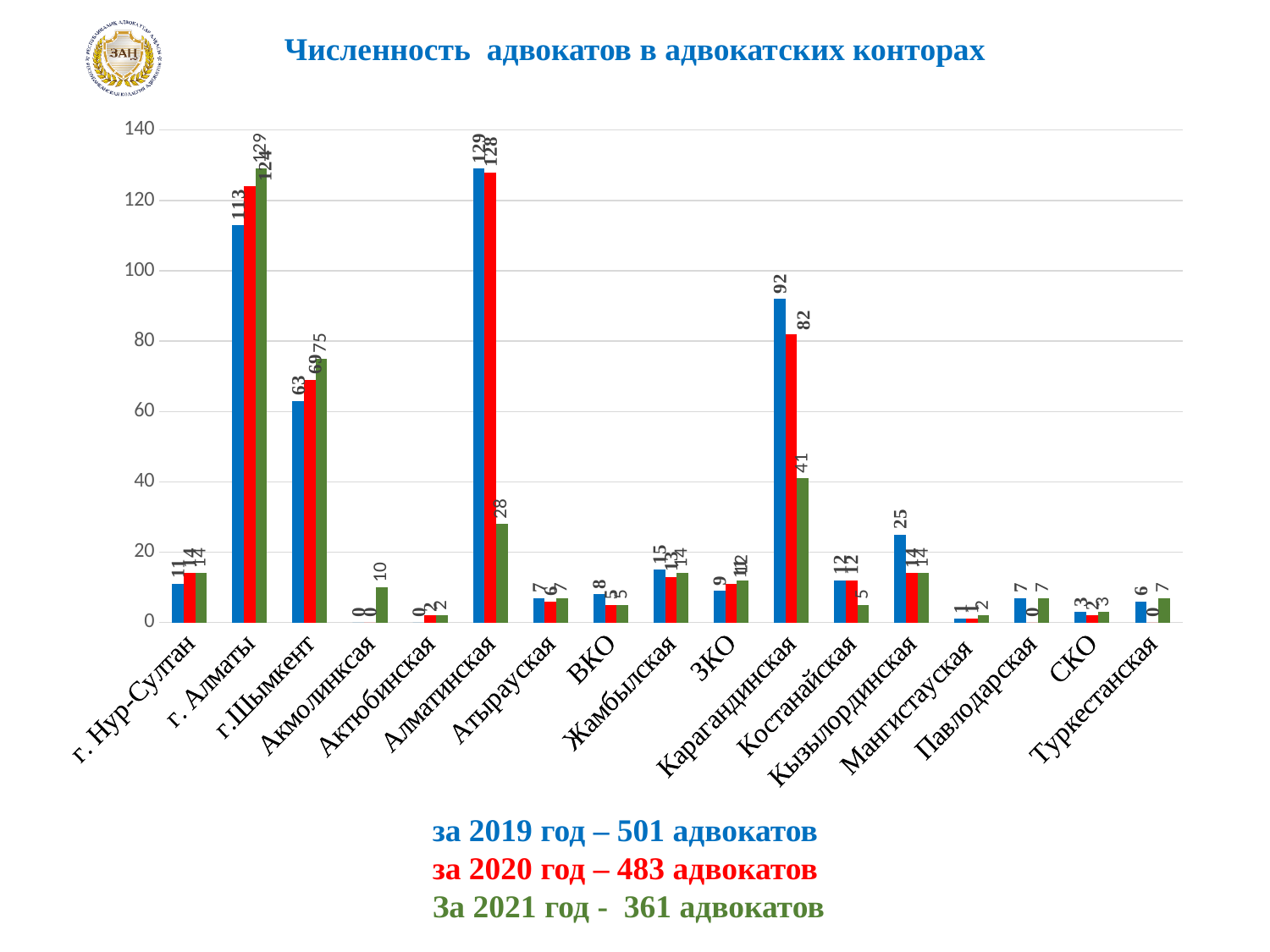
What kind of chart is shown on the slide? bar chart How many regions (categories) are shown along the x axis of the chart? 17 What is the value of the blue (2019) bar for Кызылординская? 25 What is the difference between the blue (2019) and red (2020) bars for Карагандинская? 10 What is the value of the green (2021) bar for Акмолинская? 10 Is the green (2021) bar for г.Шымкент greater or less than 60? greater What is the title of the chart? Численность адвокатов в адвокатских конторах Do the values for г. Алматы rise or fall from the blue (2019) bar to the green (2021) bar? rise What is the value of the blue (2019) bar for Карагандинская? 92 What is the value of the green (2021) bar for Алматинская? 28 Which region has the highest green (2021) bar? г. Алматы Which is larger: the blue (2019) bar for г. Алматы or the blue (2019) bar for Алматинская? Алматинская